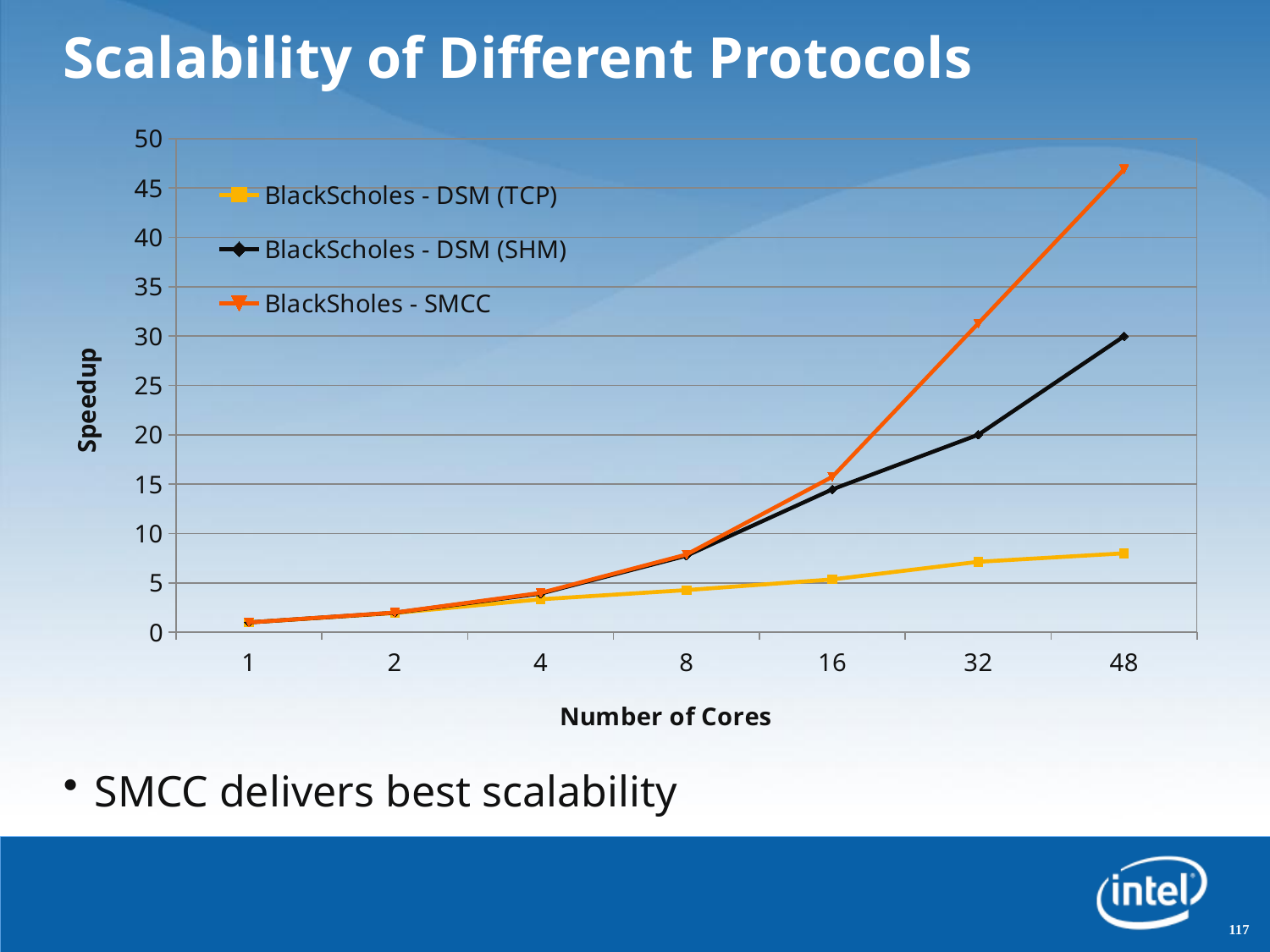
Which series has the highest speedup at 48 cores? BlackSholes - SMCC How many series does the legend list? 3 How many core counts are plotted along the x axis? 7 Does the speedup for BlackSholes - SMCC rise or fall as the number of cores increases? rise Is the speedup for BlackSholes - SMCC at 48 cores greater or less than 45? greater What is the label of the x axis? Number of Cores What kind of chart is shown on the slide? line chart Which series has the lowest speedup at 48 cores? BlackScholes - DSM (TCP) Is the speedup for BlackScholes - DSM (SHM) at 48 cores greater or less than 25? greater What is the label of the y axis? Speedup Is the speedup for BlackScholes - DSM (TCP) at 48 cores greater or less than 10? less At 32 cores, which has the larger speedup: BlackSholes - SMCC or BlackScholes - DSM (SHM)? BlackSholes - SMCC